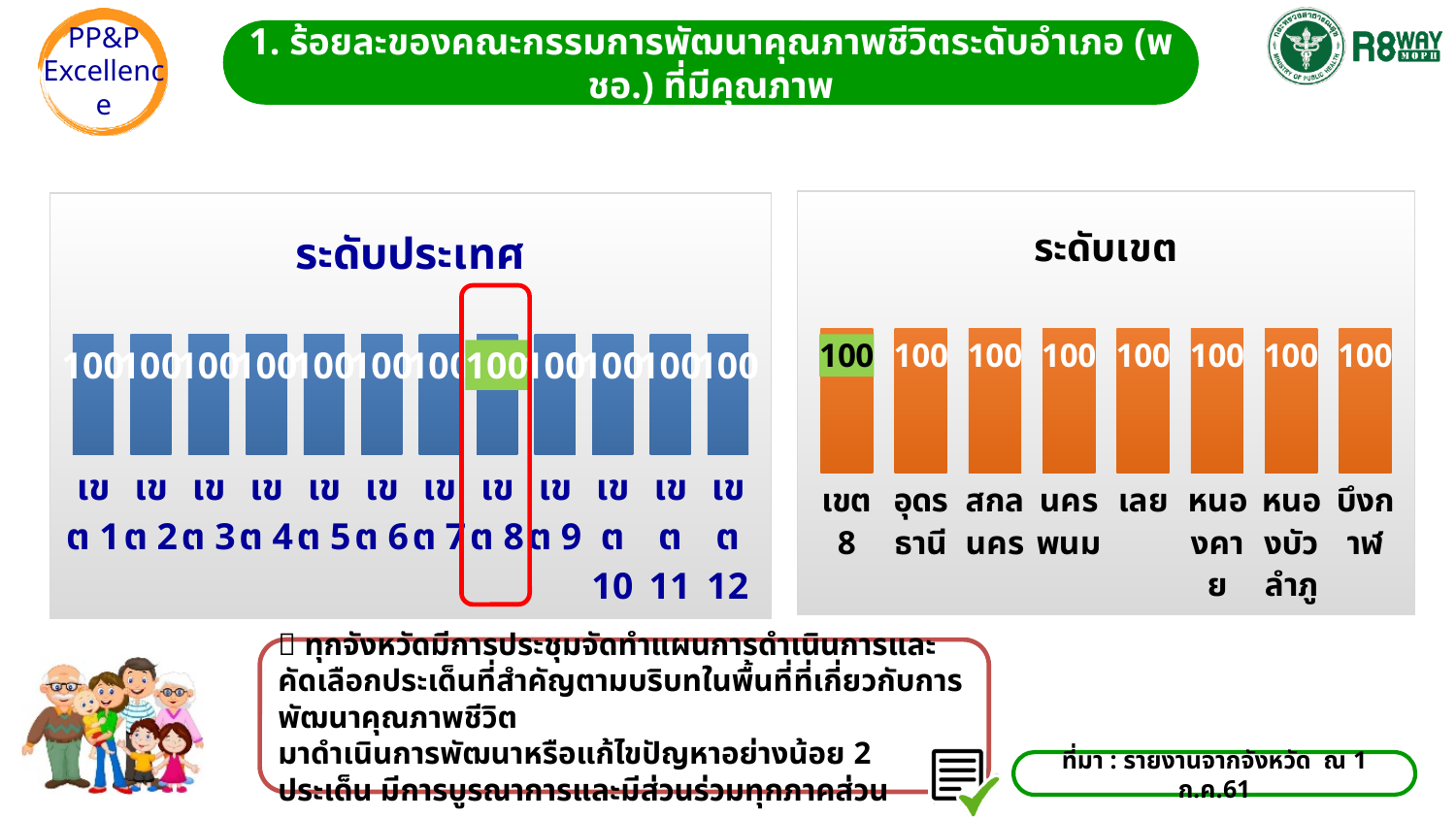
In the chart titled ระดับเขต, what is the value for บึงกาฬ? 100 In the chart titled ระดับประเทศ, which bar is highlighted in green and outlined in red? เขต 8 In the chart titled ระดับประเทศ, what is the value for เขต 12? 100 In the chart titled ระดับประเทศ, do the values rise, fall, or stay the same from เขต 1 to เขต 12? stay the same What is the title of the chart on the right side of the slide? ระดับเขต In the chart titled ระดับประเทศ, what is the value for เขต 8? 100 In the chart titled ระดับเขต, what is the value for อุดรธานี? 100 How many bars are shown in the chart titled ระดับเขต? 8 What kind of chart is the one titled ระดับประเทศ? bar chart How many bars are shown in the chart titled ระดับประเทศ? 12 In the chart titled ระดับเขต, what is the difference between the values for เลย and นครพนม? 0 What kind of chart is the one titled ระดับเขต? bar chart